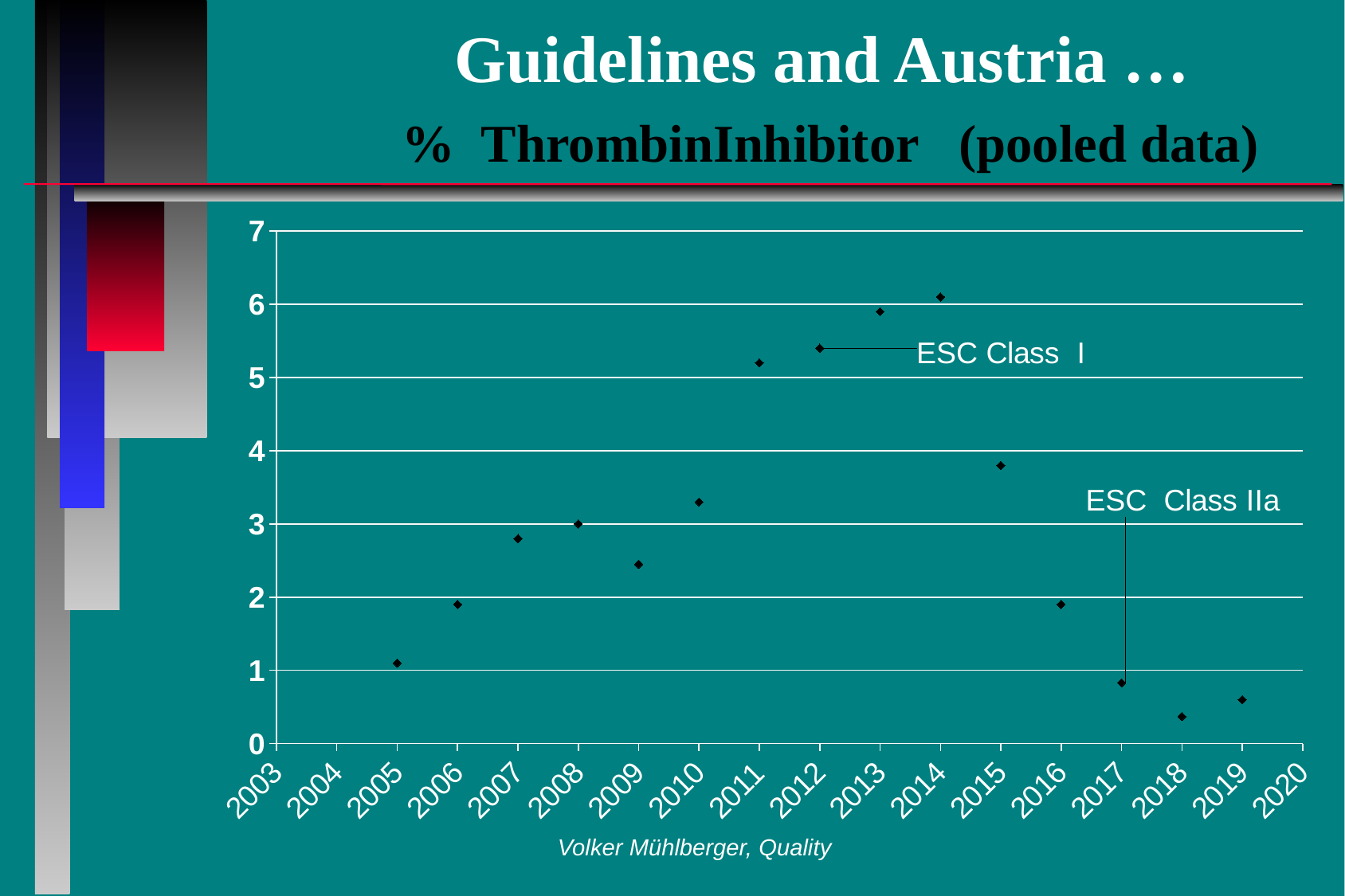
Is the value for 2010 greater or less than 3? greater Is the value for 2017 greater or less than 1? less Which year has the lowest % ThrombinInhibitor value? 2018 Do the values rise or fall from 2005 to 2014? rise What kind of chart is shown on the slide? scatter chart Which year has the highest % ThrombinInhibitor value? 2014 Is the value for 2015 greater or less than 4? less What are the two ESC class annotations shown on the chart? ESC Class I and ESC Class IIa How many data points are plotted on the chart? 15 Which year has the larger value, 2012 or 2015? 2012